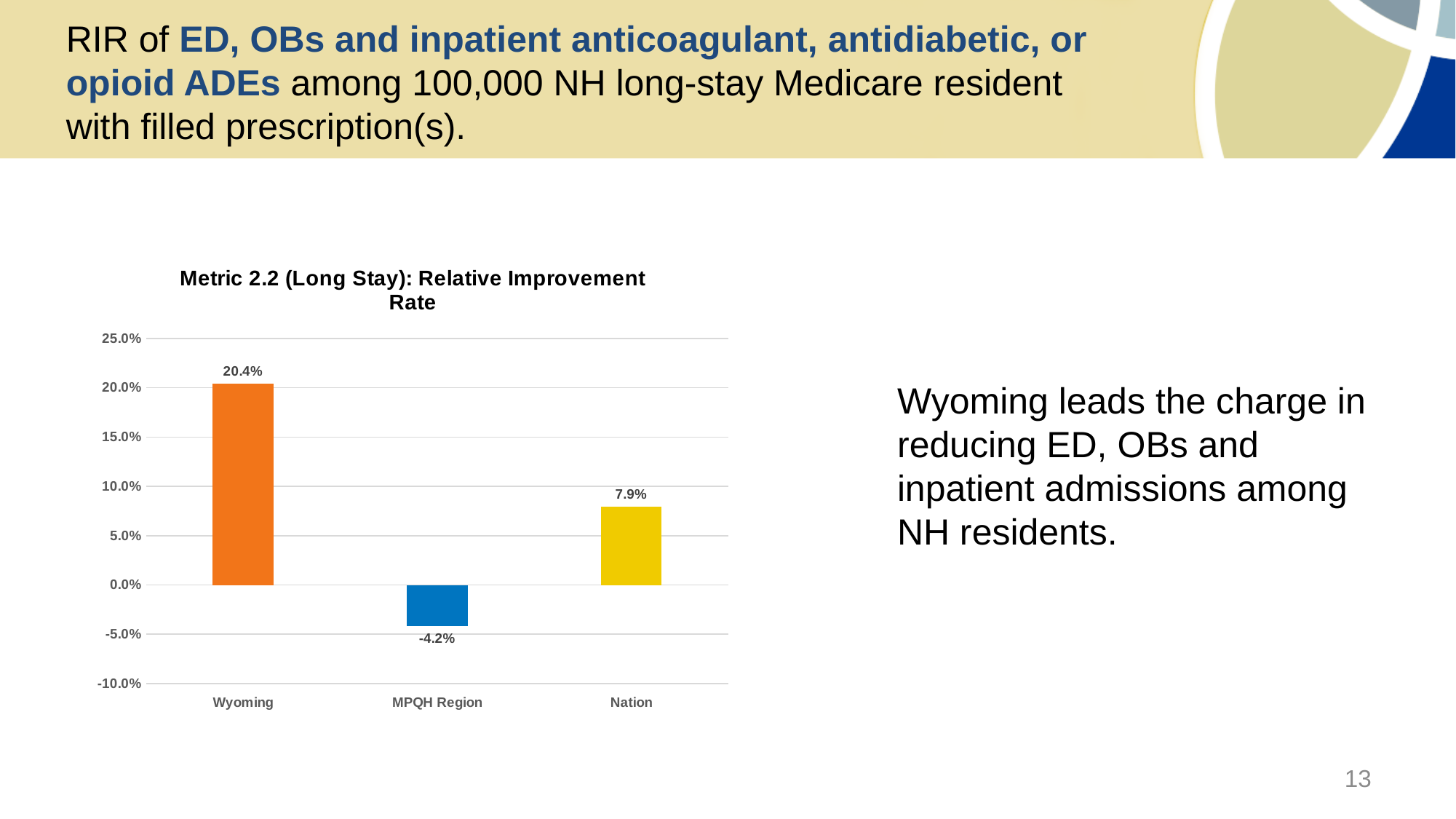
What is the difference between the relative improvement rates of Wyoming and the Nation? 12.5% What is the relative improvement rate for the MPQH Region? -4.2% Which has a larger relative improvement rate, the Nation or the MPQH Region? Nation Is the value for Wyoming greater or less than 15.0%? greater How many categories are shown in the chart? 3 Which category has the highest relative improvement rate? Wyoming What is the difference between the relative improvement rates of the Nation and the MPQH Region? 12.1% What is the relative improvement rate for Wyoming? 20.4% What is the title of the chart? Metric 2.2 (Long Stay): Relative Improvement Rate What kind of chart is shown on the slide? Bar chart What is the relative improvement rate for the Nation? 7.9% Which category has the lowest relative improvement rate? MPQH Region